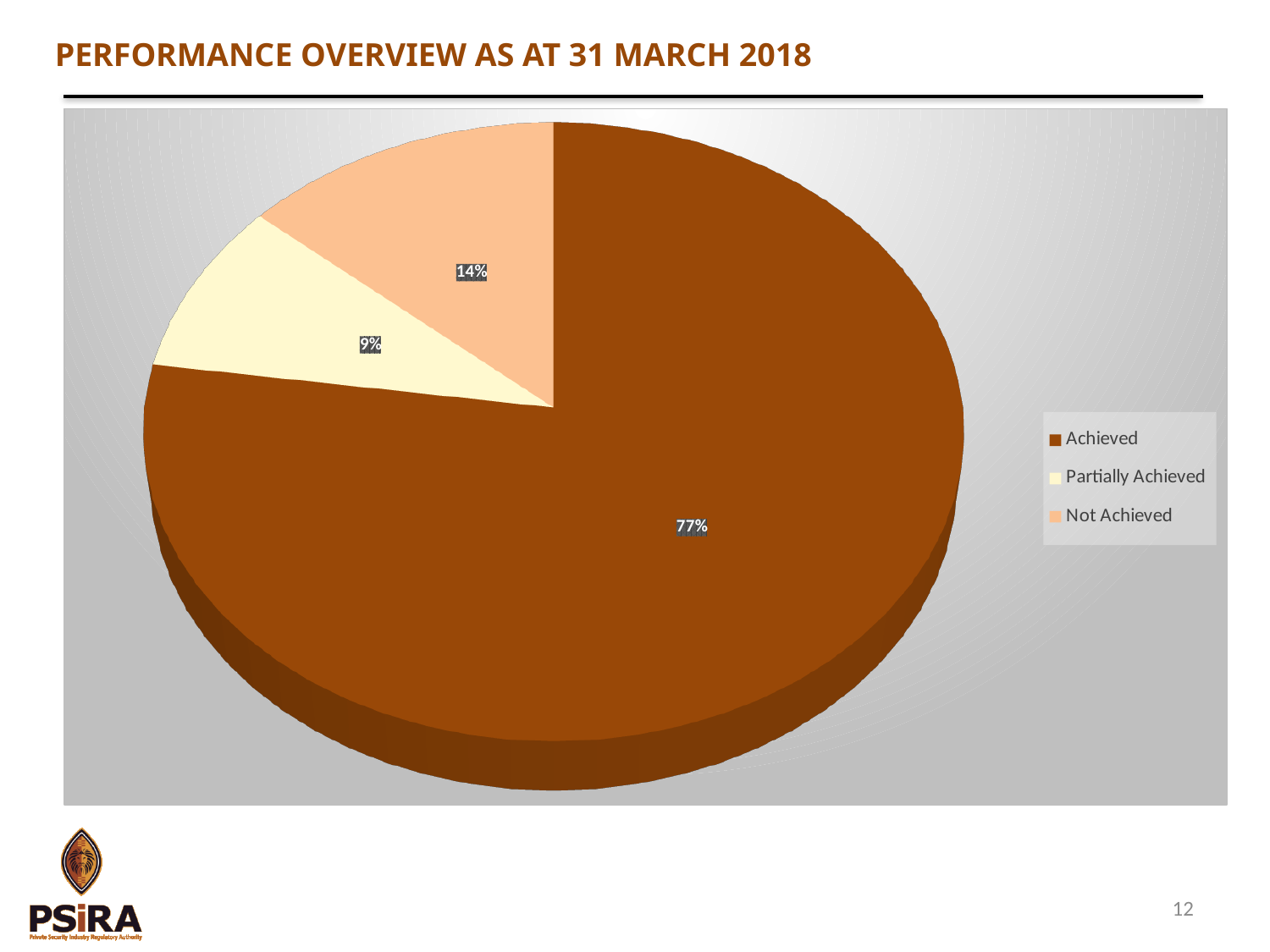
What percentage of the pie is labelled Achieved? 77% Which category has the largest slice of the pie? Achieved Which category has the smallest slice of the pie? Partially Achieved What is the difference in percentage points between the Achieved and Not Achieved slices? 63 What kind of chart is shown on the slide? pie chart What is the title of the slide containing the pie chart? PERFORMANCE OVERVIEW AS AT 31 MARCH 2018 How many slices does the pie chart have? 3 Which slice is larger, Not Achieved or Partially Achieved? Not Achieved How many entries does the legend list? 3 What percentage of the pie is labelled Partially Achieved? 9% What percentage of the pie is labelled Not Achieved? 14% What is the difference in percentage points between the Not Achieved and Partially Achieved slices? 5